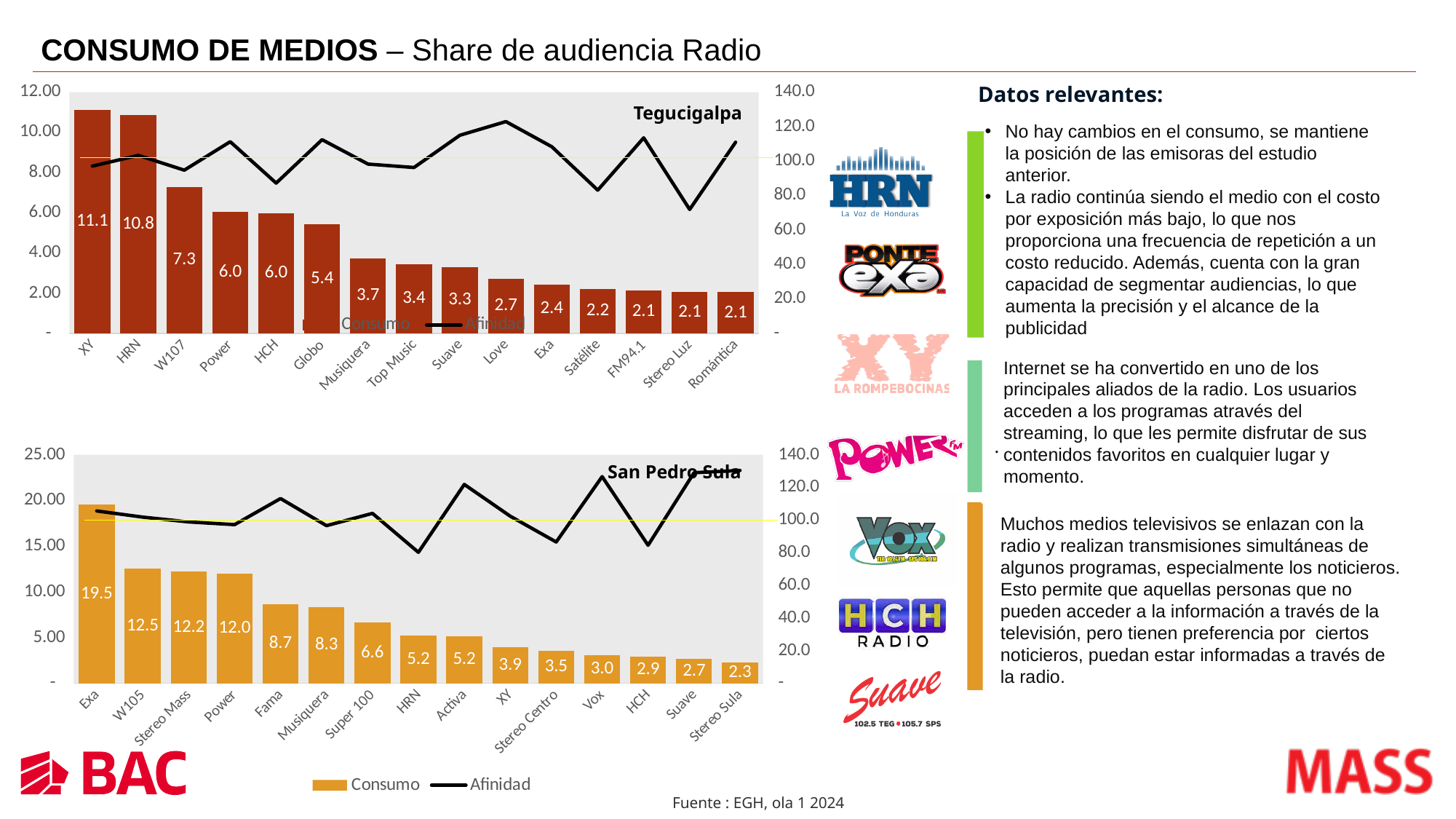
In the Tegucigalpa chart, what is the Consumo value for HRN? 10.8 In the Tegucigalpa chart, what is the difference between the Consumo values for XY and W107? 3.8 In the Tegucigalpa chart, is the Afinidad value for Stereo Luz greater or less than 100? less In the San Pedro Sula chart, what is the Consumo value for Exa? 19.5 In the Tegucigalpa chart, how many stations are shown on the x axis? 15 In the Tegucigalpa chart, which station has the highest Consumo value? XY In the San Pedro Sula chart, is the Afinidad value for HRN greater or less than 100? less What kind of chart is the Tegucigalpa chart? Combined bar and line chart In the San Pedro Sula chart, what is the difference between the Consumo values for Exa and W105? 7.0 How many series does the legend of the San Pedro Sula chart list? 2 In the San Pedro Sula chart, which station has the lowest Consumo value? Stereo Sula In the San Pedro Sula chart, which has a higher Consumo value, Fama or Super 100? Fama